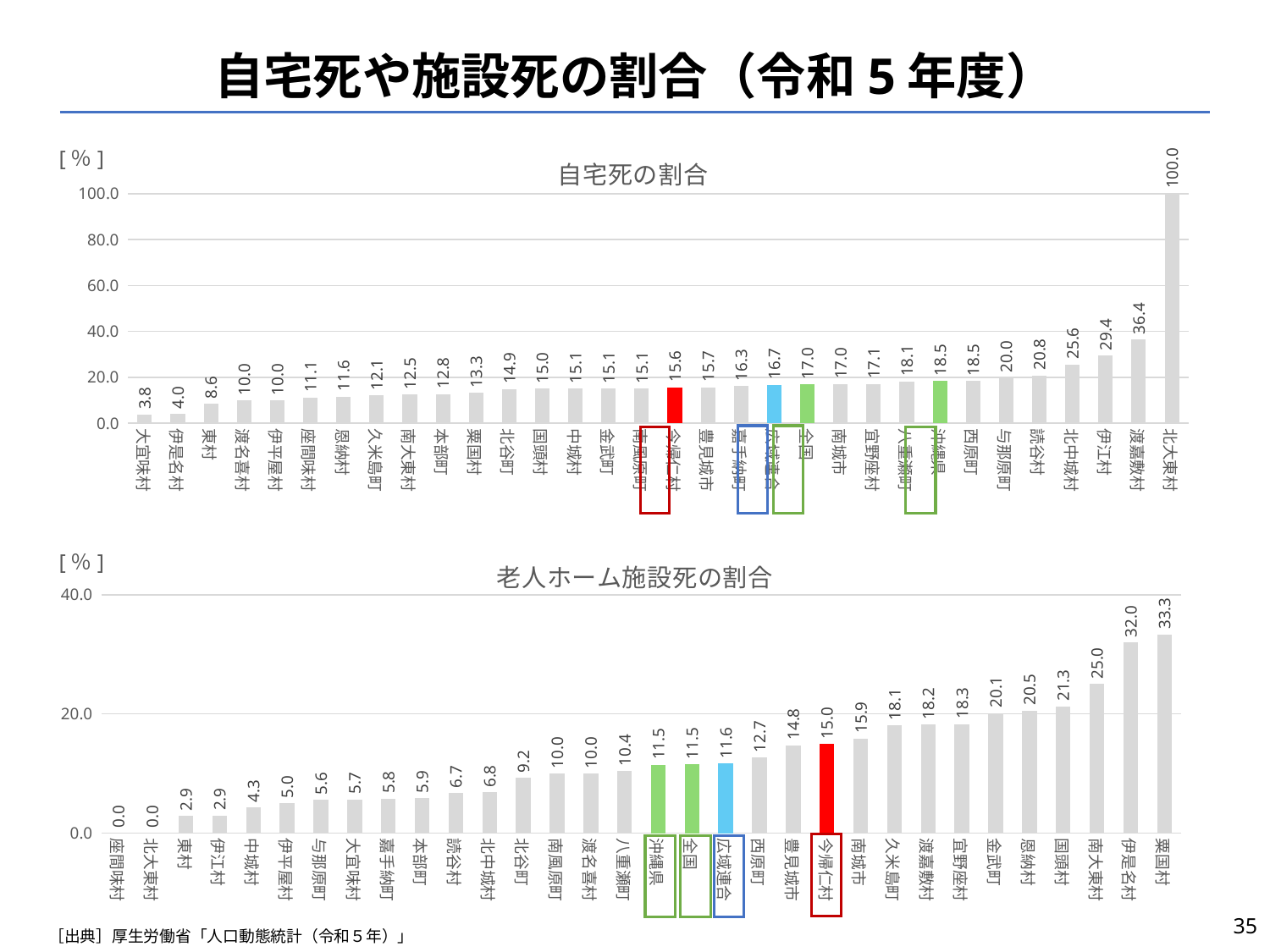
In the top chart (自宅死の割合), what is the difference between 渡嘉敷村 and 伊江村? 7.0 What type of chart is the top chart (自宅死の割合)? Bar chart In the bottom chart (老人ホーム施設死の割合), what is the difference between 粟国村 and 伊是名村? 1.3 In the bottom chart (老人ホーム施設死の割合), which category has the highest value? 粟国村 How many bars are plotted in the bottom chart (老人ホーム施設死の割合)? 32 In the top chart (自宅死の割合), which category has the highest value? 北大東村 In the top chart (自宅死の割合), what is the value for 全国? 17.0 In the top chart (自宅死の割合), which category has the lowest value? 大宜味村 In the bottom chart (老人ホーム施設死の割合), which is larger, 南城市 or 西原町? 南城市 In the bottom chart (老人ホーム施設死の割合), what is the value for 今帰仁村? 15.0 In the top chart (自宅死の割合), what is the value for 今帰仁村? 15.6 In the bottom chart (老人ホーム施設死の割合), what is the value for 広域連合? 11.6